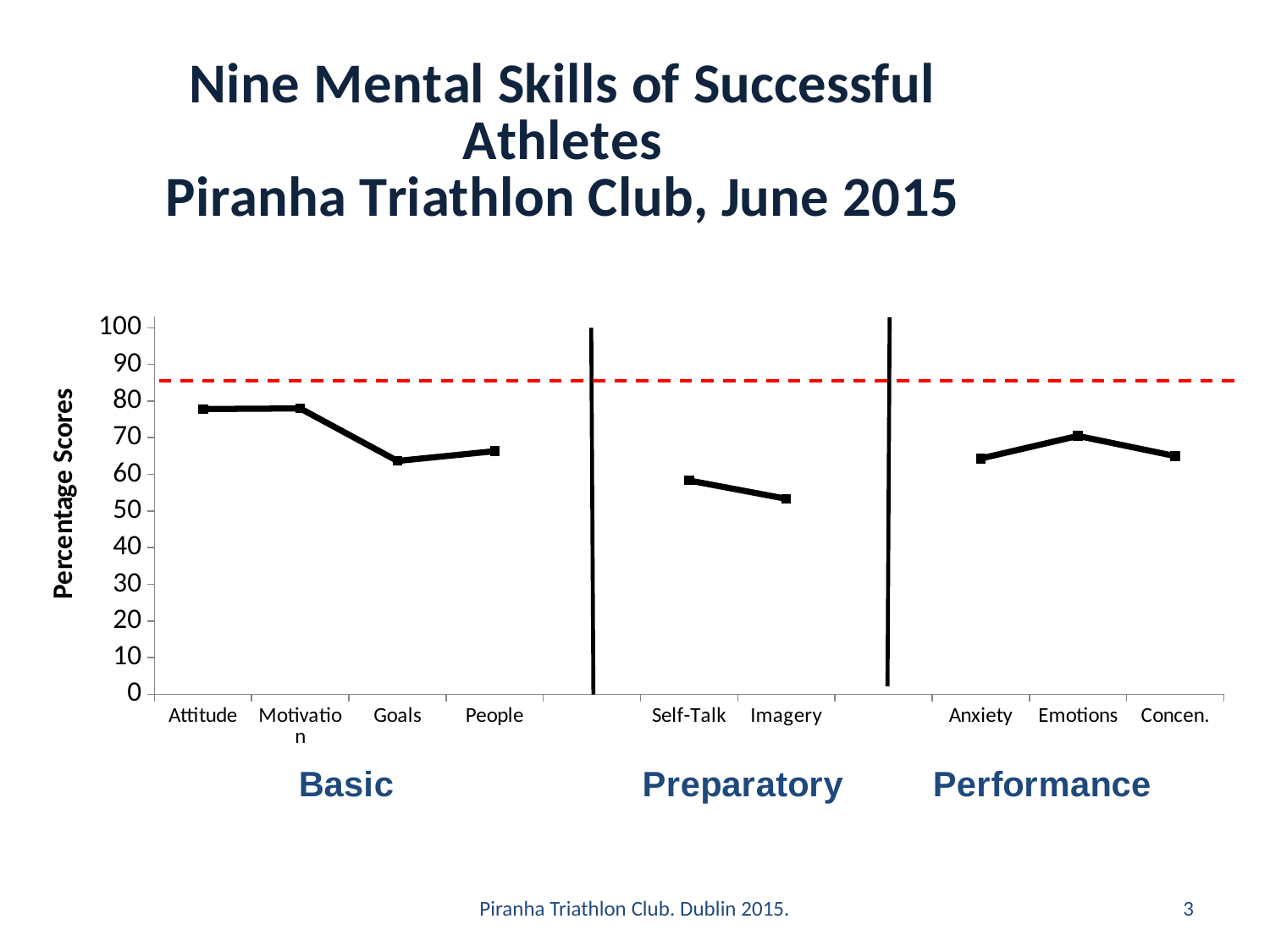
How many mental skills (categories) are plotted along the x axis? 9 What is the title of the vertical axis? Percentage Scores Which has the higher percentage score, Attitude or Goals? Attitude Do the values rise or fall from Self-Talk to Imagery? fall Is the value for Imagery greater or less than 60? less What are the three group labels shown beneath the x axis? Basic, Preparatory, Performance Which has the higher percentage score, Anxiety or Emotions? Emotions Is the value for Goals greater or less than 70? less Is the value for Attitude greater or less than 70? greater Which category has the lowest percentage score? Imagery What kind of chart is shown on the slide? line chart